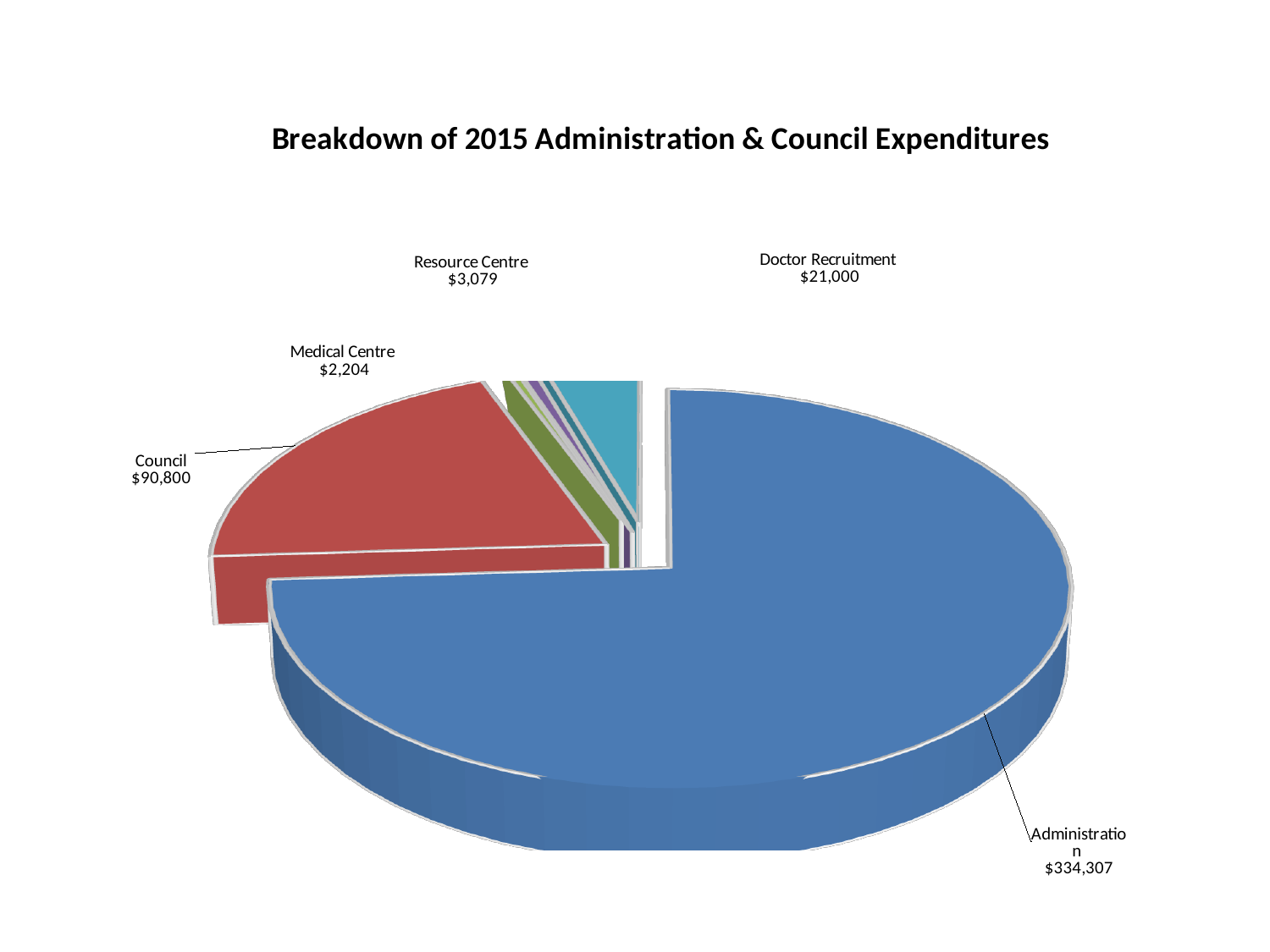
What is the difference between the Council and Doctor Recruitment values? $69,800 What is the value shown for Council? $90,800 What is the value shown for Doctor Recruitment? $21,000 Which is larger, Resource Centre or Medical Centre? Resource Centre What is the value shown for Resource Centre? $3,079 Which category has the largest slice of the pie? Administration What kind of chart is shown on the slide? Pie chart What is the difference between the Administration and Council values? $243,507 What is the value shown for Administration? $334,307 Of the labelled categories, which has the lowest value? Medical Centre What is the value shown for Medical Centre? $2,204 What is the title of the chart? Breakdown of 2015 Administration & Council Expenditures